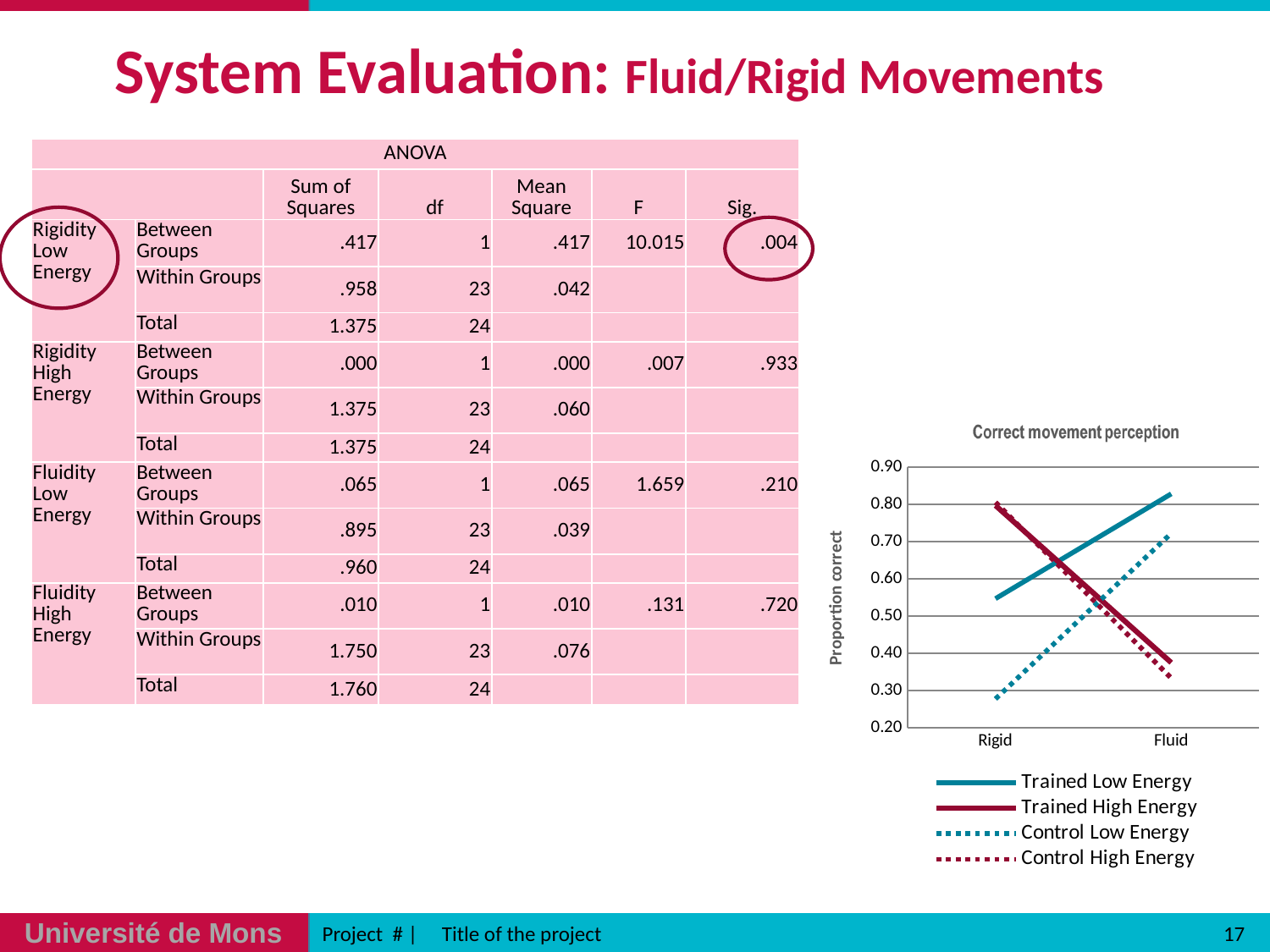
In the "Correct movement perception" chart, at Rigid, which is larger: Trained High Energy or Trained Low Energy? Trained High Energy In the "Correct movement perception" chart, is the value for Trained Low Energy at Rigid greater or less than 0.50? greater How many categories are shown on the x axis of the "Correct movement perception" chart? 2 In the "Correct movement perception" chart, does the Trained Low Energy line rise or fall from Rigid to Fluid? rise In the "Correct movement perception" chart, at Fluid, which is larger: Trained Low Energy or Control Low Energy? Trained Low Energy In the "Correct movement perception" chart, does the Trained High Energy line rise or fall from Rigid to Fluid? fall In the "Correct movement perception" chart, is the value for Control High Energy at Rigid greater or less than 0.70? greater In the "Correct movement perception" chart, is the value for Control Low Energy at Rigid greater or less than 0.40? less What kind of chart is "Correct movement perception"? line chart How many series does the legend of the "Correct movement perception" chart list? 4 What is the y-axis title of the "Correct movement perception" chart? Proportion correct